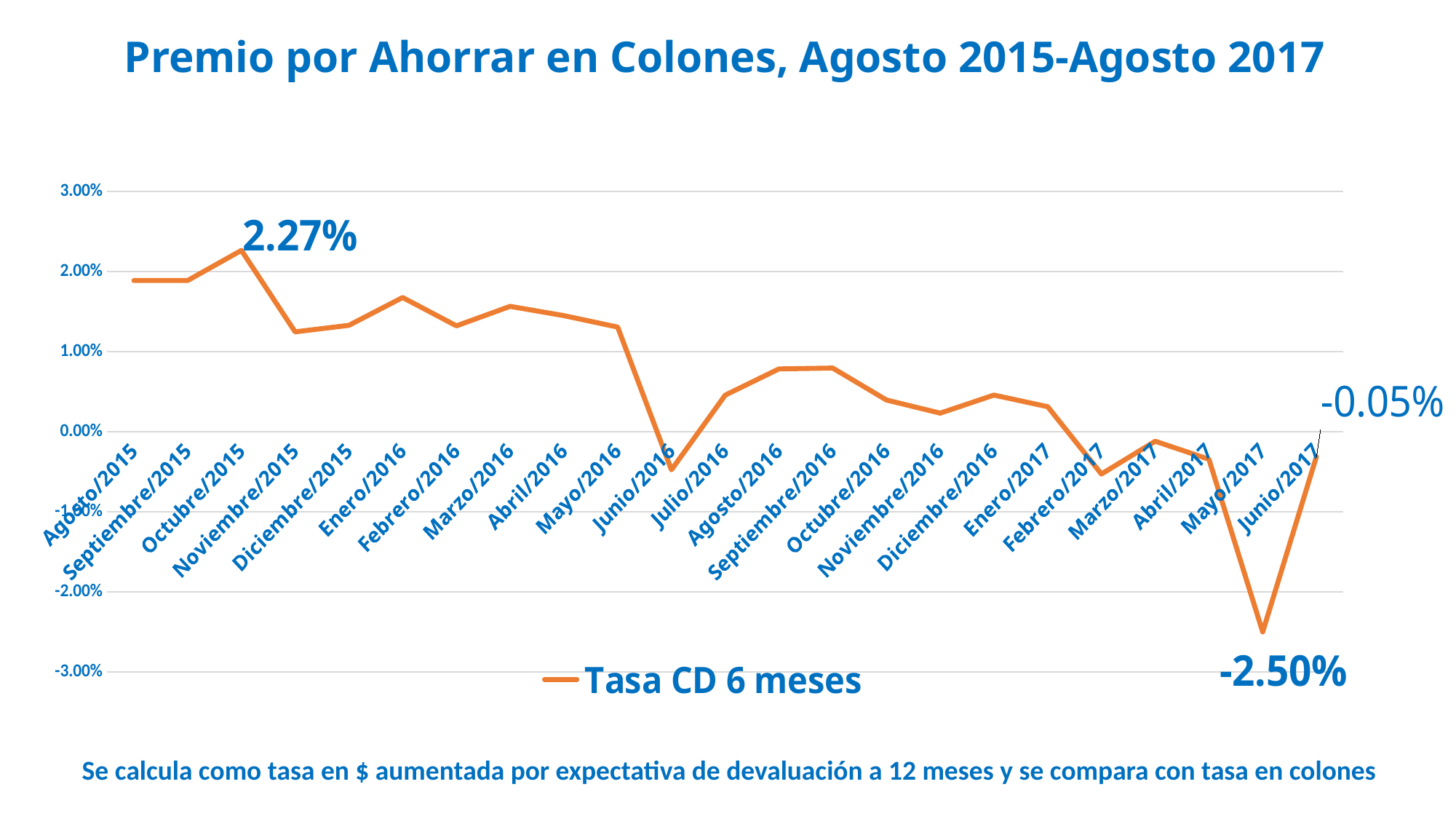
What is the value for Octubre/2015? 2.27% What is the value for Mayo/2017? -2.50% What is the value for Junio/2017? -0.05% What series name does the legend show? Tasa CD 6 meses What is the difference between the value for Octubre/2015 and the value for Mayo/2017? 4.77 percentage points Is the value for Agosto/2015 greater or less than 1.00%? greater What is the title of the chart? Premio por Ahorrar en Colones, Agosto 2015-Agosto 2017 Which month has the highest value of Tasa CD 6 meses? Octubre/2015 What kind of chart is shown on the slide? line chart Which month has the lowest value of Tasa CD 6 meses? Mayo/2017 How many series does the legend list? 1 How many months are plotted along the x axis? 23